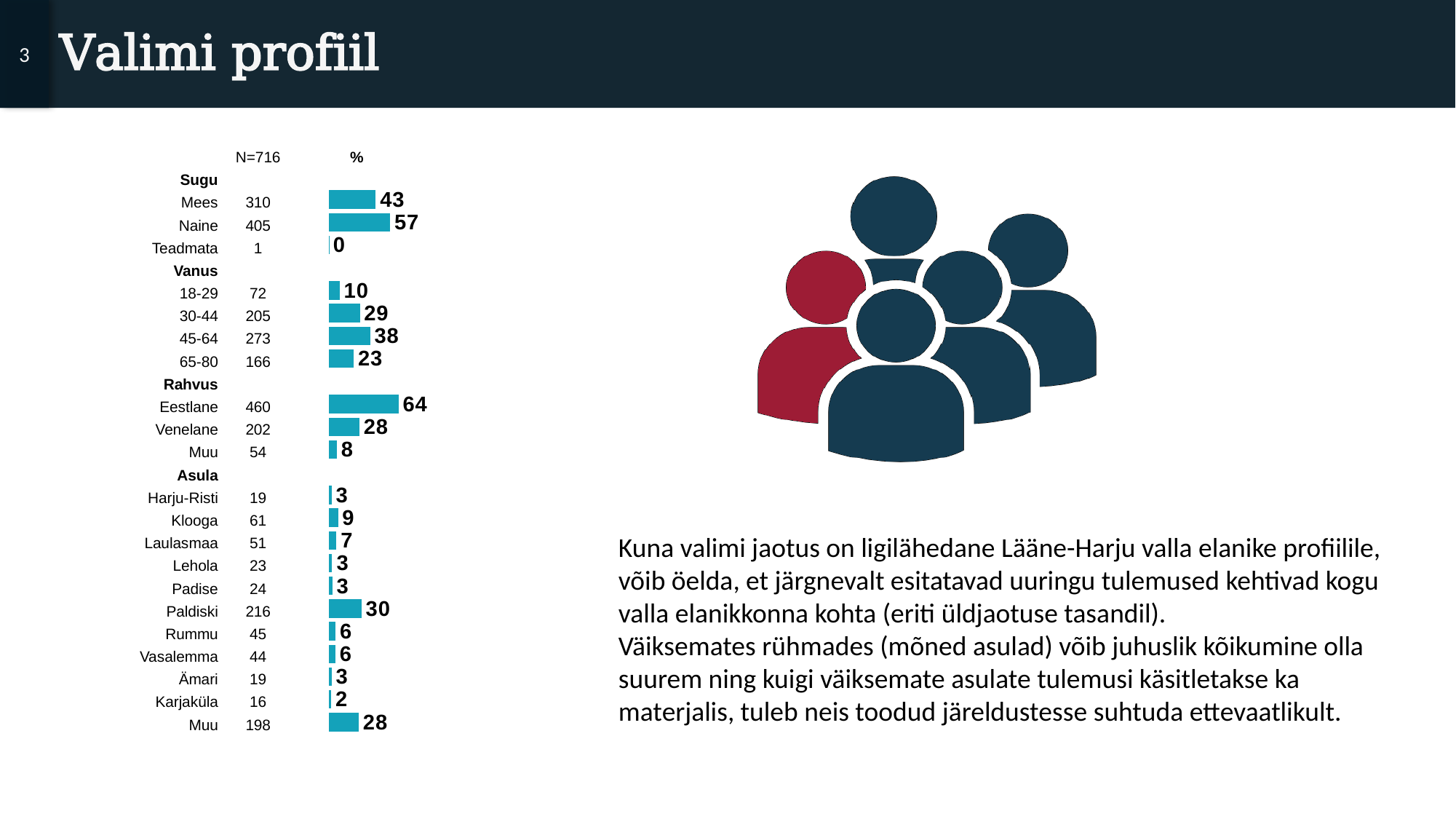
What percentage is shown for Paldiski? 30 How many bars are plotted in the chart in total? 21 Which has a larger percentage, Venelane or the 65-80 age group? Venelane What is the difference in percentage between Eestlane and Venelane? 36 Which category under Rahvus has the highest percentage? Eestlane What is the total sample size (N) shown above the chart? 716 What percentage is shown for Naine? 57 What is the difference in percentage between Naine and Mees? 14 What percentage is shown for the 45-64 age group? 38 Which age group under Vanus has the lowest percentage? 18-29 What kind of chart is shown on the slide? Bar chart Which asula has the lowest percentage? Karjaküla